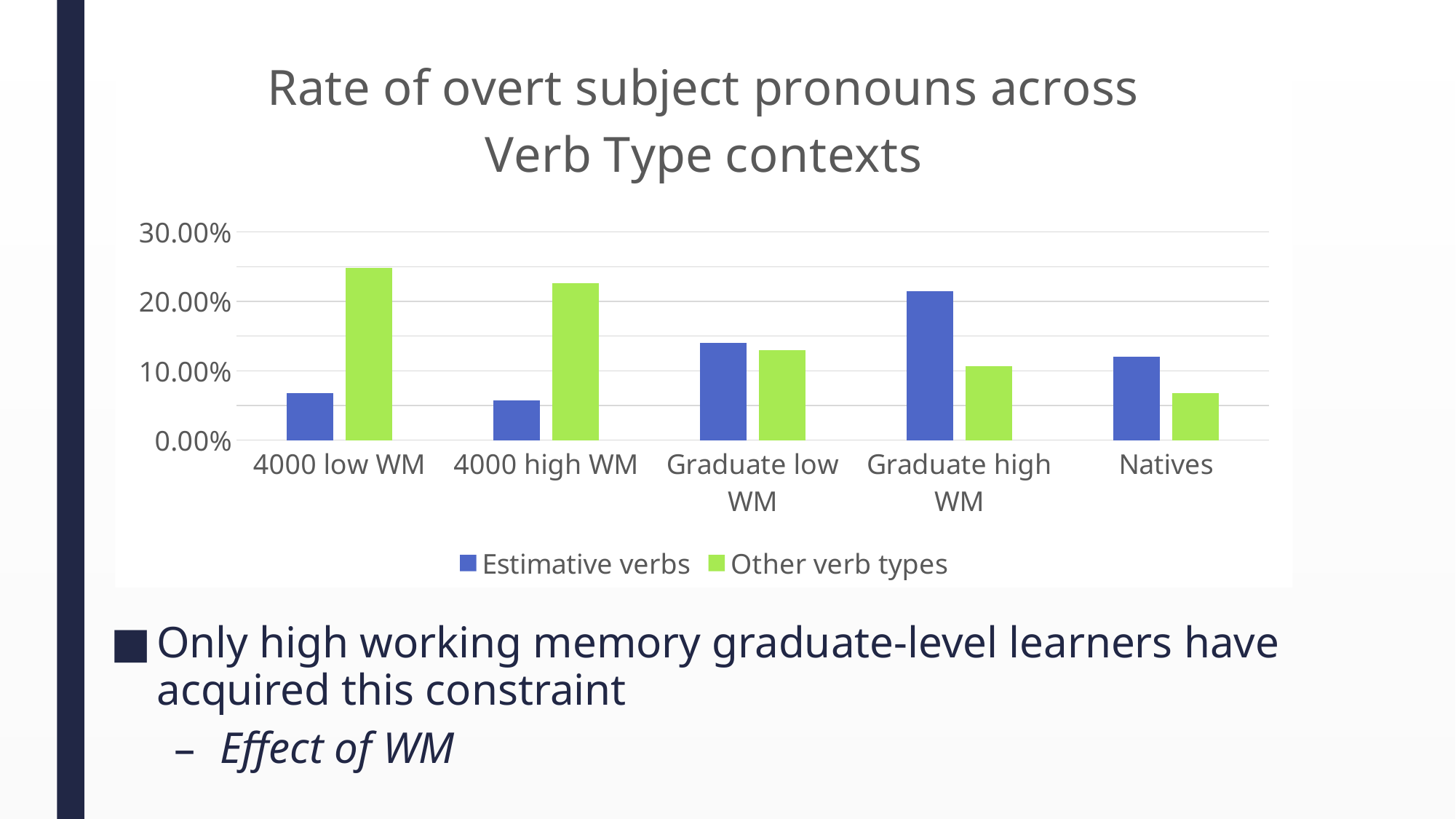
Is the value for Other verb types in the 4000 low WM group greater or less than 20.00%? greater How many series does the legend list? 2 Is the value for Other verb types in the Natives group greater or less than 10.00%? less Which group has the lowest value for Other verb types? Natives Which group has the highest value for Estimative verbs? Graduate high WM In the Graduate high WM group, which is larger: Estimative verbs or Other verb types? Estimative verbs What kind of chart is shown on the slide? bar chart Is the value for Estimative verbs in the Graduate high WM group greater or less than 20.00%? greater How many groups are shown on the x axis? 5 Which group has the highest value for Other verb types? 4000 low WM What is the title of the chart? Rate of overt subject pronouns across Verb Type contexts